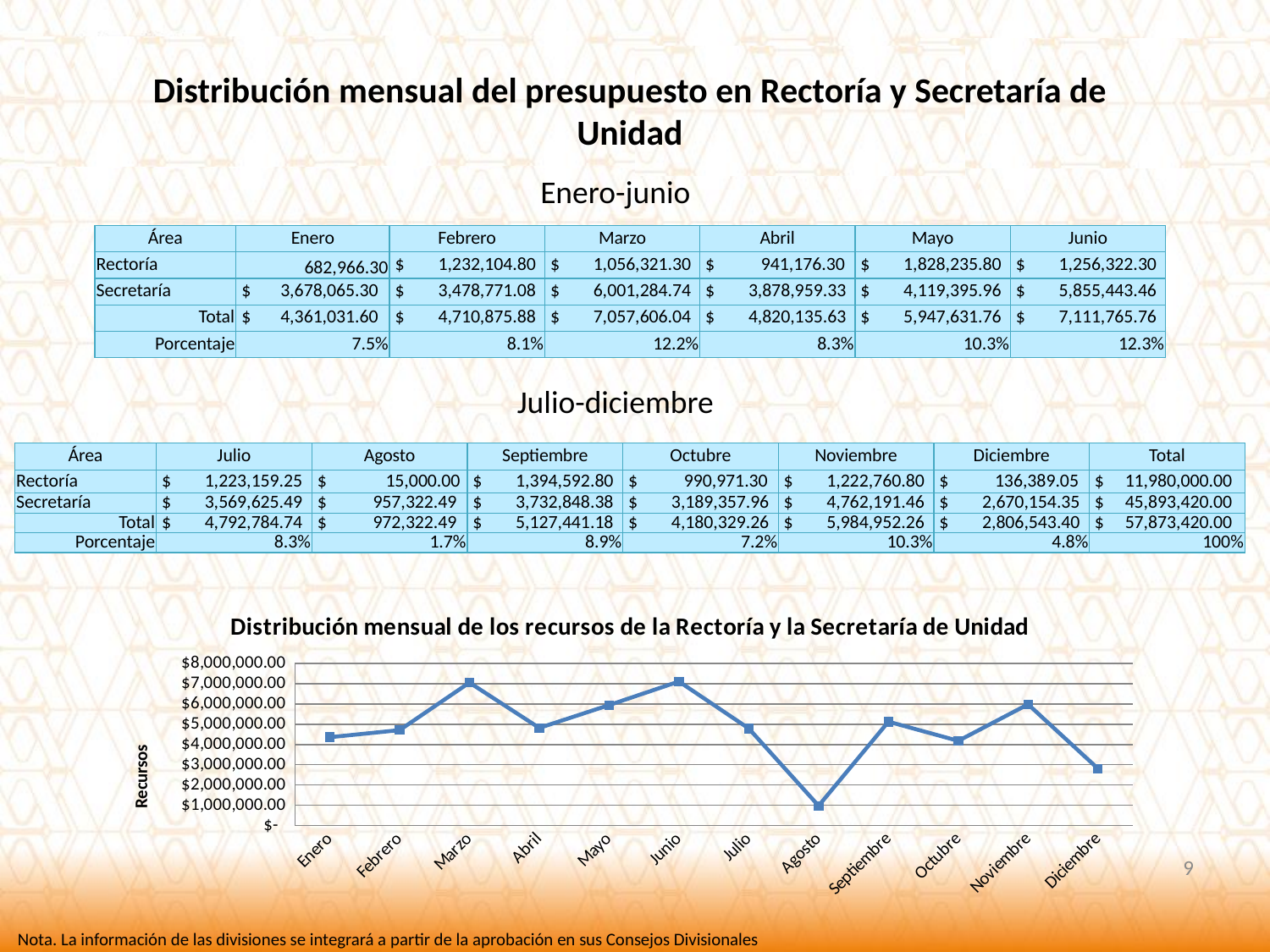
In the line chart, is the value for Marzo greater or less than $6,000,000.00? greater What is the label on the vertical axis of the line chart? Recursos In the line chart, is the value for Noviembre greater or less than $5,000,000.00? greater In the line chart, does the value rise or fall from Julio to Agosto? fall In the line chart, which month has the larger value, Julio or Agosto? Julio What kind of chart is shown at the bottom of the slide? line chart What is the title of the line chart? Distribución mensual de los recursos de la Rectoría y la Secretaría de Unidad Which month has the lowest value in the line chart? Agosto In the line chart, which month has the larger value, Marzo or Abril? Marzo How many months are plotted along the x axis of the line chart? 12 In the line chart, is the value for Octubre greater or less than $5,000,000.00? less